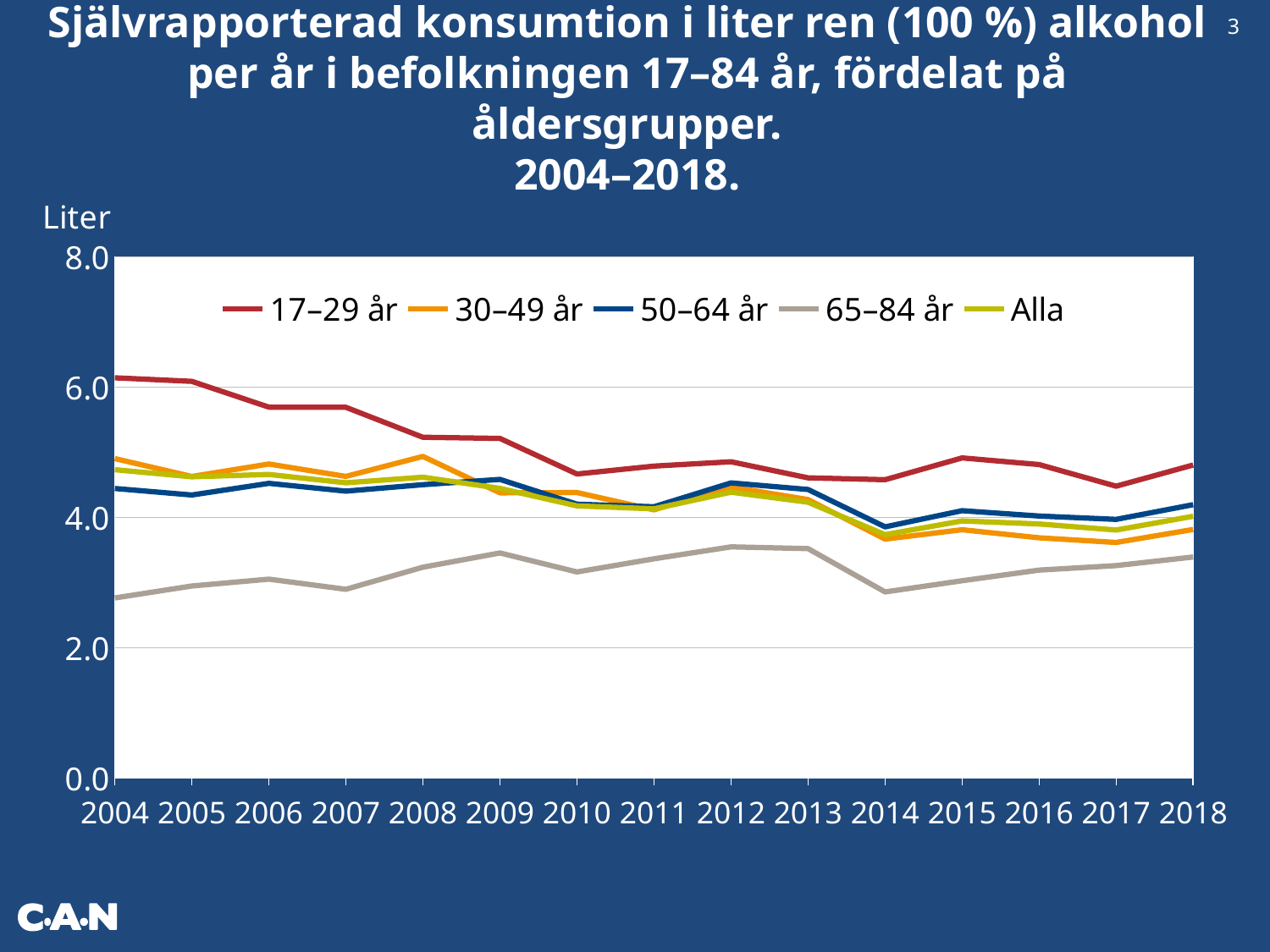
Which age group has the highest consumption in 2004? 17–29 år Does the line for 17–29 år rise or fall from 2004 to 2014? Fall Which is larger in 2010, the value for 17–29 år or the value for 65–84 år? 17–29 år How many series does the legend list? 5 How many years are shown along the x axis? 15 Is the value for 17–29 år in 2010 greater or less than 6.0? less What label is shown on the vertical axis? Liter What kind of chart is shown on the slide? Line chart Which age group has the lowest consumption in 2018? 65–84 år Is the value for 30–49 år in 2017 greater or less than 4.0? less Is the value for 65–84 år in 2004 greater or less than 4.0? less